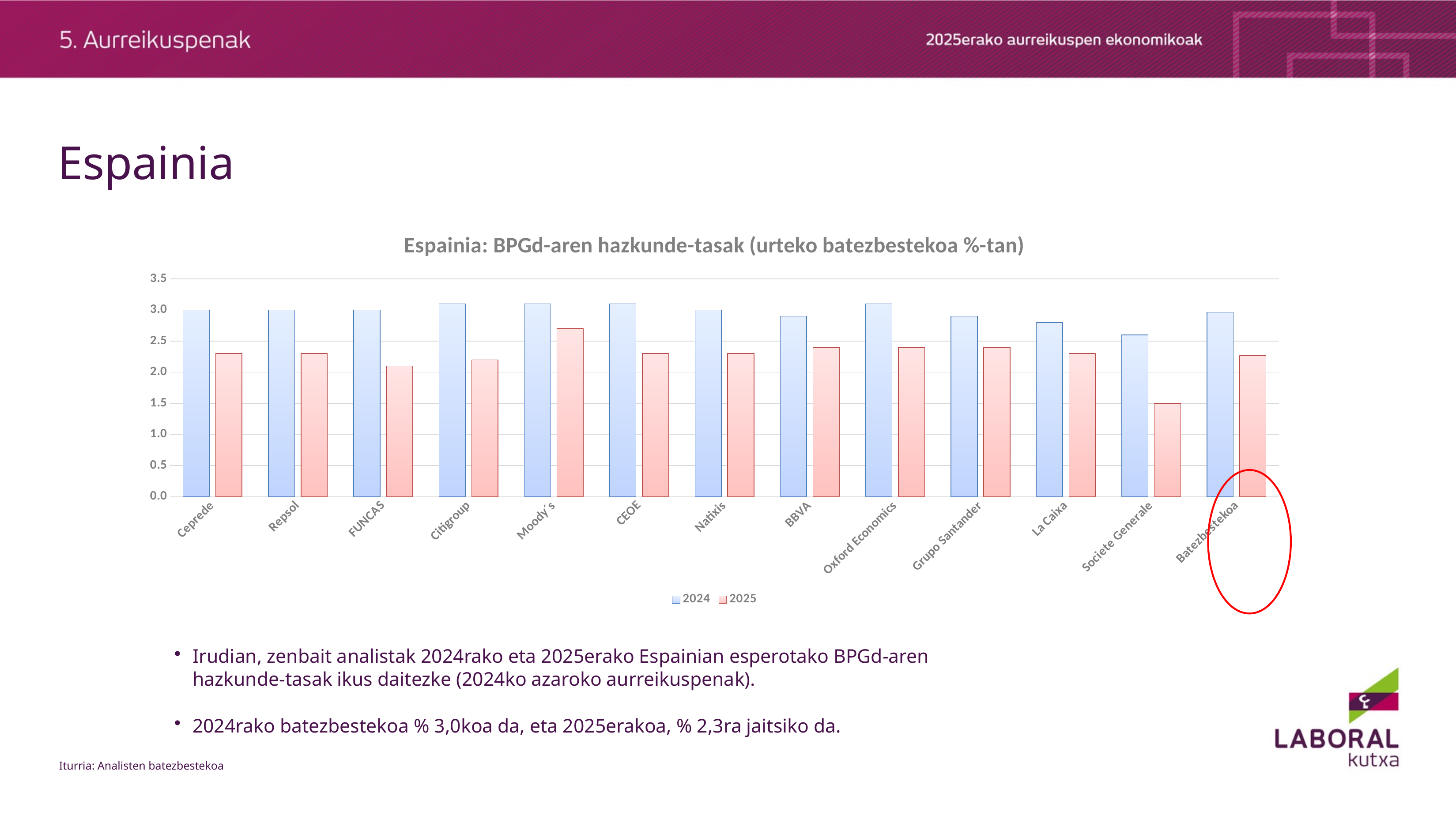
Is the 2025 value for FUNCAS greater or less than 2.5? less What kind of chart is shown on the slide? bar chart How many series does the chart legend list? 2 Is the 2025 value for Moody's greater or less than 2.5? greater How many analysts/categories are shown on the x axis of the chart? 13 Is the 2025 value for Societe Generale greater or less than 2.0? less Which category has the lowest 2025 value? Societe Generale What are the two series named in the chart legend? 2024 and 2025 Which category has the lowest 2024 value? Societe Generale Which category has the highest 2025 value? Moody's Which is larger: the 2024 value for La Caixa or the 2024 value for Societe Generale? La Caixa